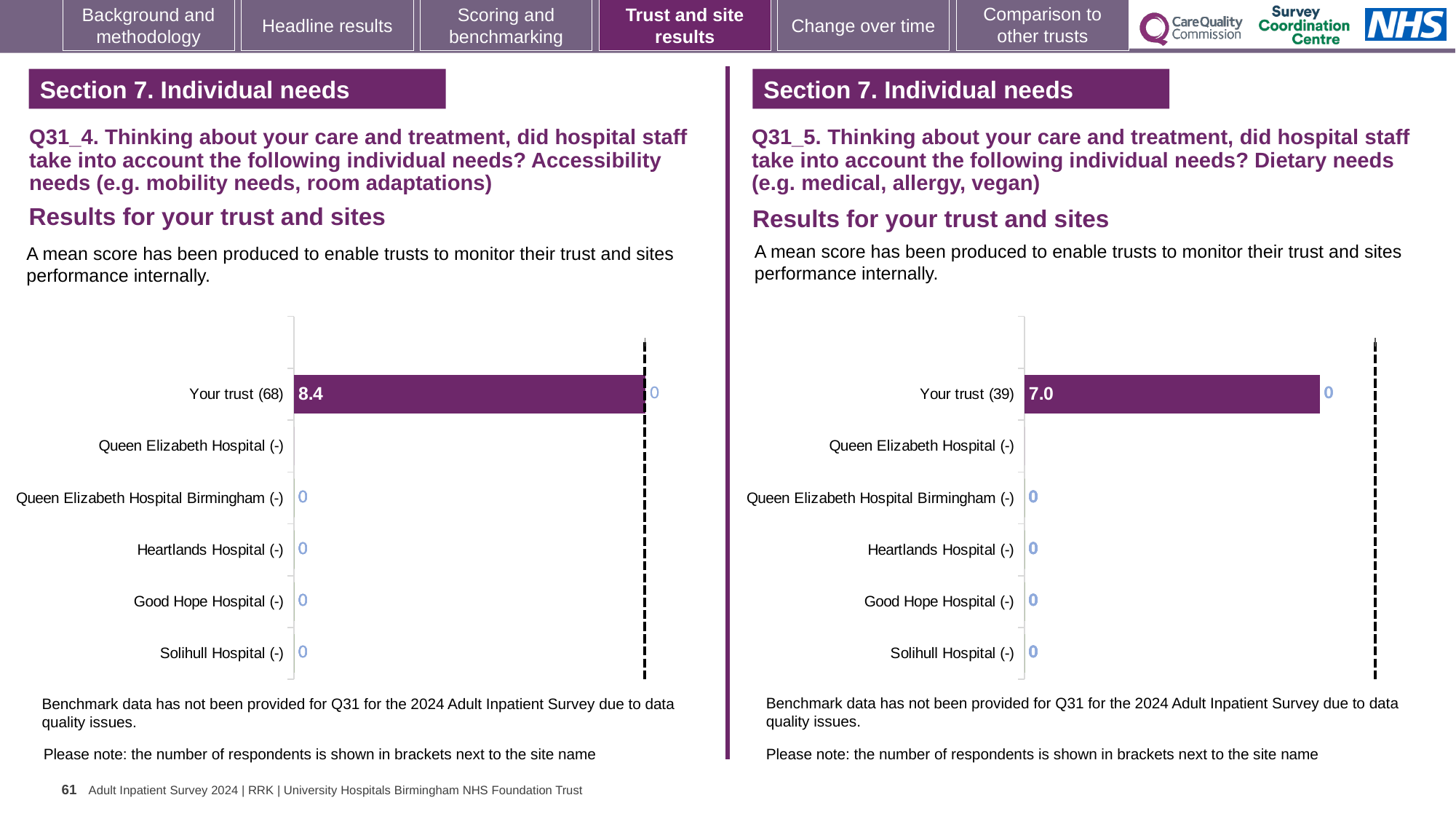
How many categories (trust and sites) are listed on the left chart (Q31_4)? 6 Which is larger: the Your trust score in the left chart (Q31_4) or the Your trust score in the right chart (Q31_5)? Left chart (Q31_4), 8.4 What type of chart is used in the left chart (Q31_4)? Bar chart In the right chart (Q31_5), how many respondents are shown in brackets next to Your trust? 39 How many categories (trust and sites) are listed on the right chart (Q31_5)? 6 In the left chart (Q31_4, Accessibility needs), what is the mean score for Your trust? 8.4 In the right chart (Q31_5, Dietary needs), what is the mean score for Your trust? 7.0 What is the section title shown above both charts? Section 7. Individual needs What is the difference between the Your trust score in the left chart (Q31_4) and the Your trust score in the right chart (Q31_5)? 1.4 In the left chart (Q31_4), what value is shown for Solihull Hospital? 0 In the left chart (Q31_4), how many respondents are shown in brackets next to Your trust? 68 In the right chart (Q31_5), which category has the highest mean score? Your trust